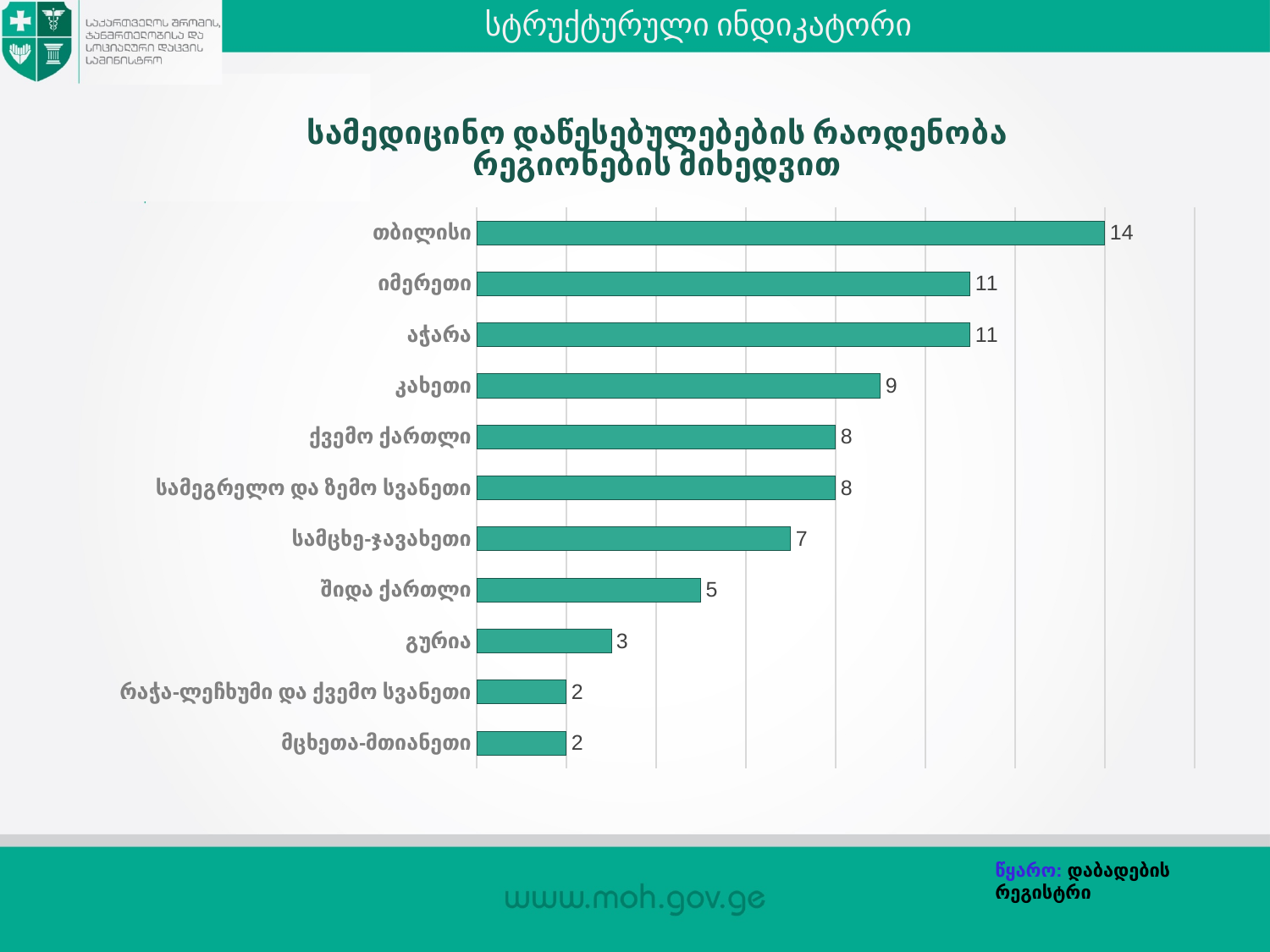
What is the title of the chart? სამედიცინო დაწესებულებების რაოდენობა რეგიონების მიხედვით What is the difference between the values for თბილისი and იმერეთი? 3 What is the value for კახეთი? 9 What is the value for გურია? 3 What is the difference between the values for შიდა ქართლი and მცხეთა-მთიანეთი? 3 Which region has the highest value? თბილისი Which is larger, the value for ქვემო ქართლი or the value for შიდა ქართლი? ქვემო ქართლი What type of chart is shown on the slide? bar chart What is the lowest value shown in the chart? 2 What is the value for თბილისი? 14 How many regions are shown in the chart? 11 What is the value for სამცხე-ჯავახეთი? 7